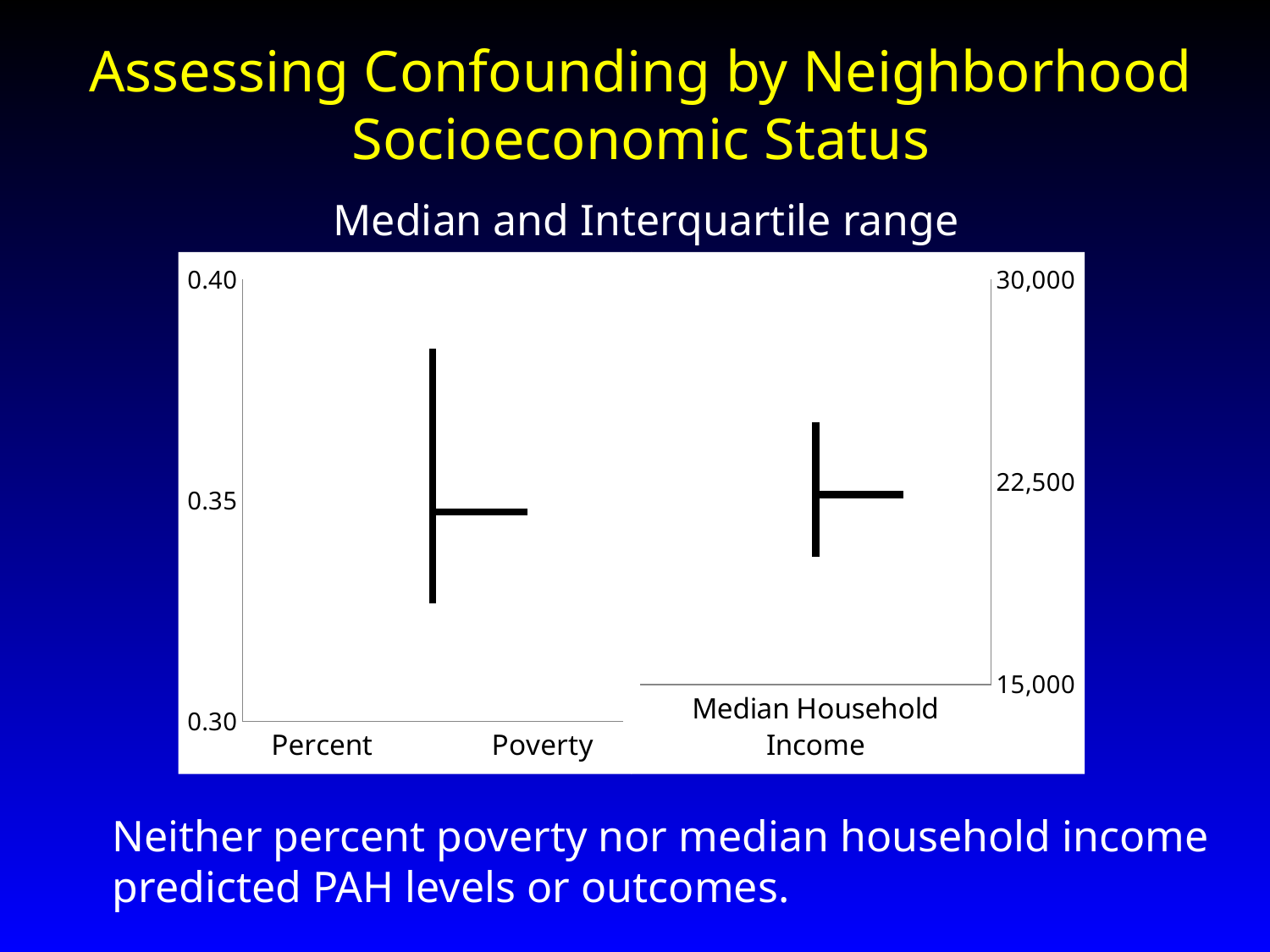
Is the median for Percent Poverty greater or less than 0.40? less What is the lowest tick label on the right vertical axis? 15,000 Is the lower end of the interquartile range for Median Household Income greater or less than 22,500? less Is the upper end of the interquartile range for Percent Poverty greater or less than 0.35? greater How many variables are plotted in the chart? 2 What is the highest tick label on the left vertical axis? 0.40 What is the title of the chart? Median and Interquartile range What is the middle tick label on the right vertical axis? 22,500 What are the two variables shown in the chart? Percent Poverty and Median Household Income